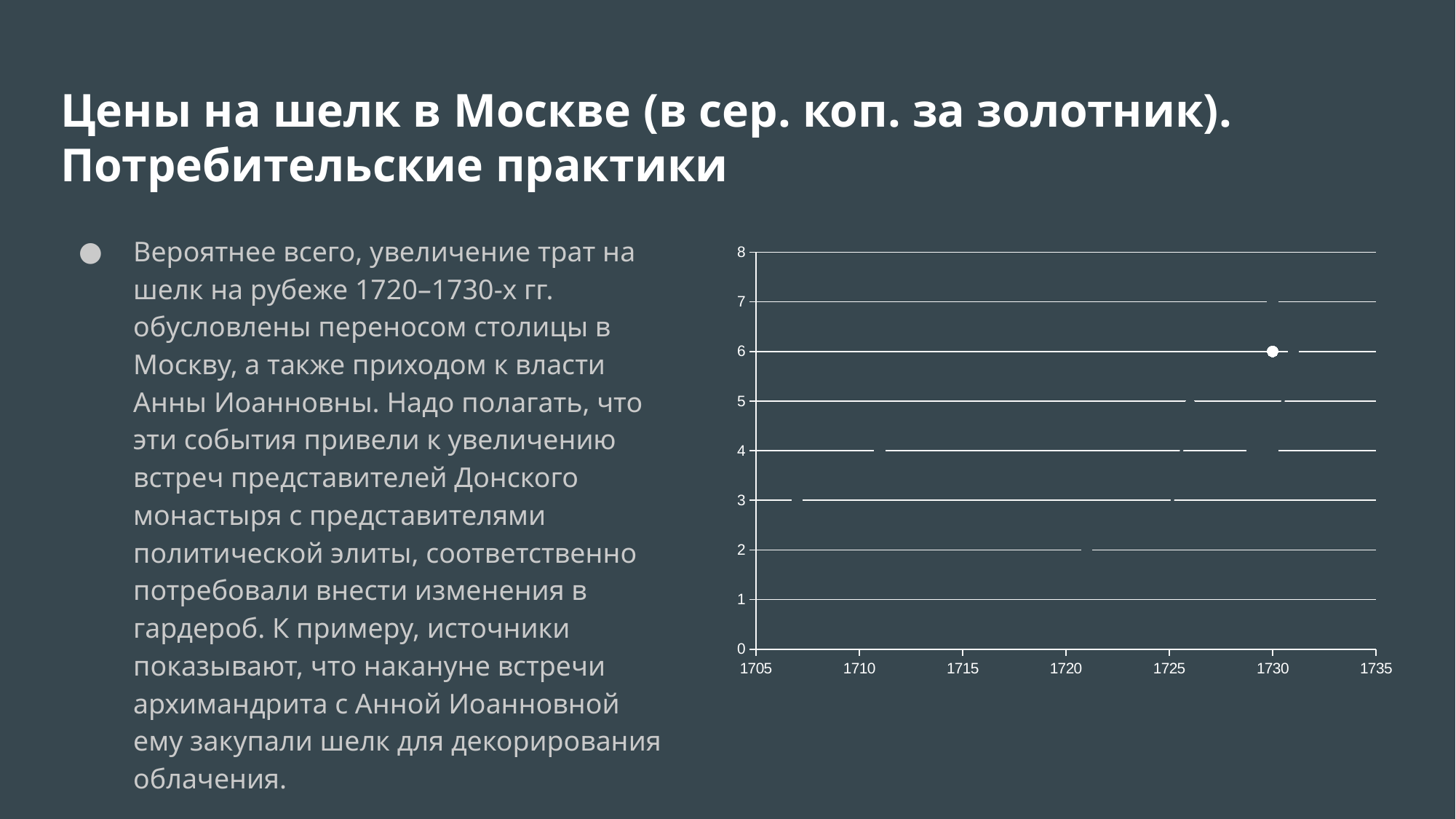
What is the value of the clearly visible point plotted at 1730? 6 What range of years does the horizontal axis of the chart cover? 1705 to 1735 What kind of chart is shown on the slide? scatter chart Is the value of the point plotted at 1730 greater or less than 7? less What is the highest value shown on the vertical axis of the chart? 8 Is the value of the point plotted at 1730 greater or less than 5? greater